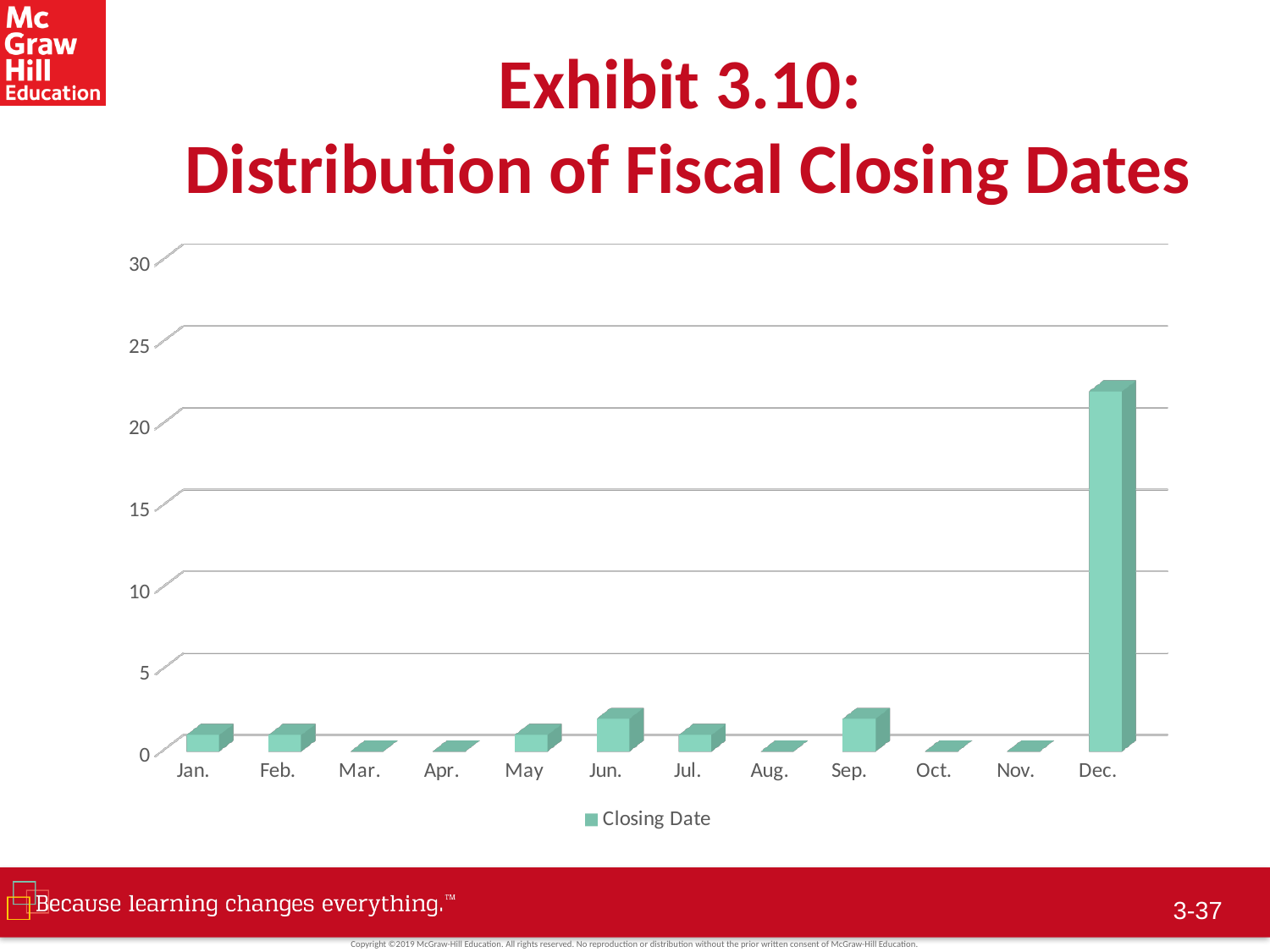
Which month has the highest value in the chart? Dec. How many months (categories) are shown on the x axis? 12 Is the value for Dec. greater or less than 25? less What kind of chart is shown on the slide? bar chart What is the title of the exhibit shown on the slide? Exhibit 3.10: Distribution of Fiscal Closing Dates Which is larger, the value for Dec. or the value for Jun.? Dec. Is the value for Sep. greater or less than 5? less Is the value for Jun. greater or less than 5? less What is the name of the series shown in the legend? Closing Date Which is larger, the value for Jun. or the value for Mar.? Jun. How many series does the legend list? 1